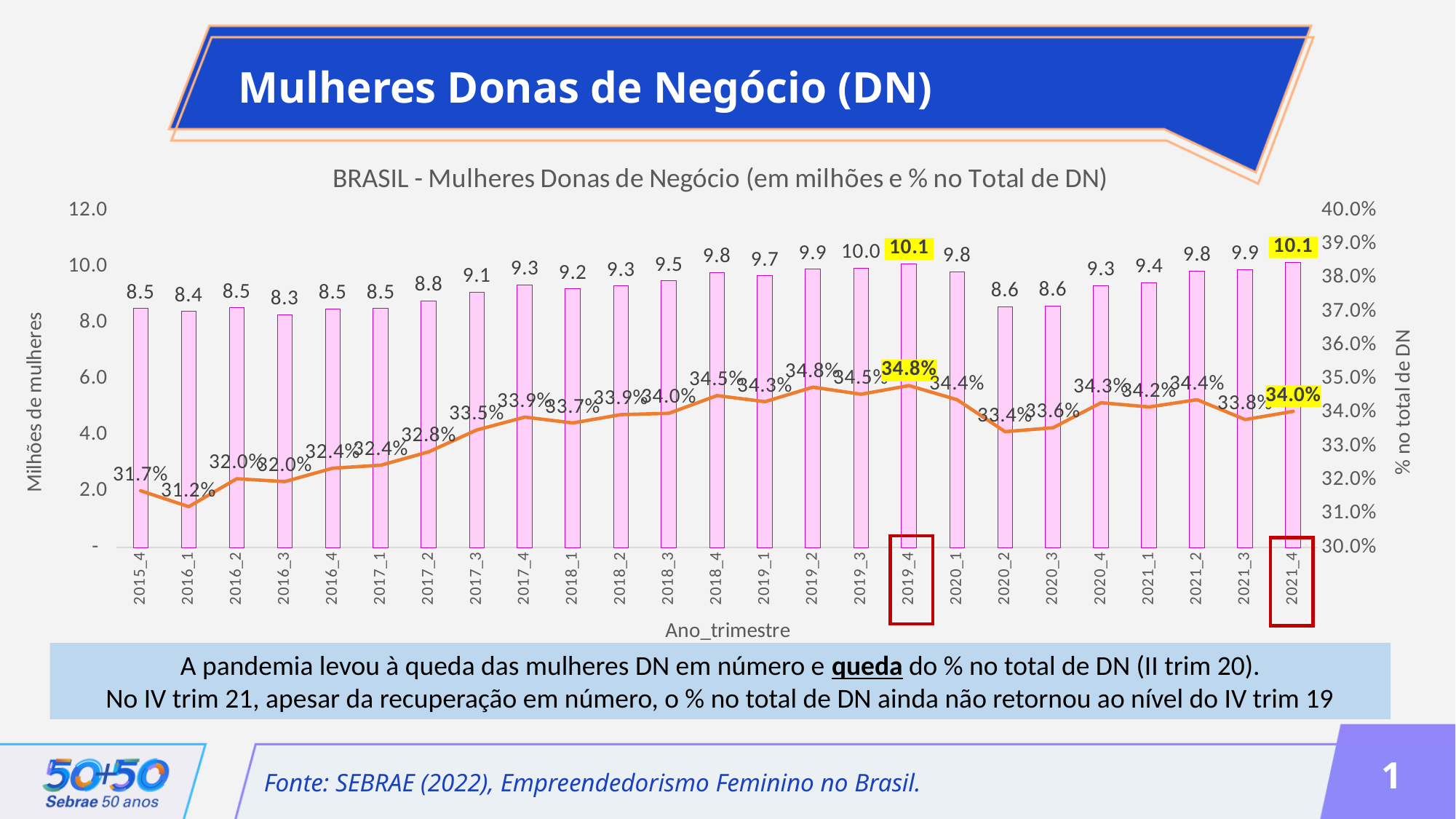
By how many percentage points does the % no total de DN in 2019_4 exceed that in 2021_4? 0.8 What is the difference between the bar values for 2019_4 and 2020_2? 1.5 What percentage of total DN do women represent in 2020_2? 33.4% What is the value of the bar for 2017_2? 8.8 Which quarter has the lowest percentage on the line (% no total de DN)? 2016_1 What is the title of the chart? BRASIL - Mulheres Donas de Negócio (em milhões e % no Total de DN) Which quarter has the lowest bar value (millions of women)? 2016_3 Which quarter has a higher bar value, 2018_4 or 2020_4? 2018_4 How many quarters (categories) are shown on the x axis? 25 What kind of chart is this? Bar chart with a line Do the bar values generally rise or fall from 2015_4 to 2019_4? Rise What is the number of women business owners (in millions) shown for 2019_4? 10.1